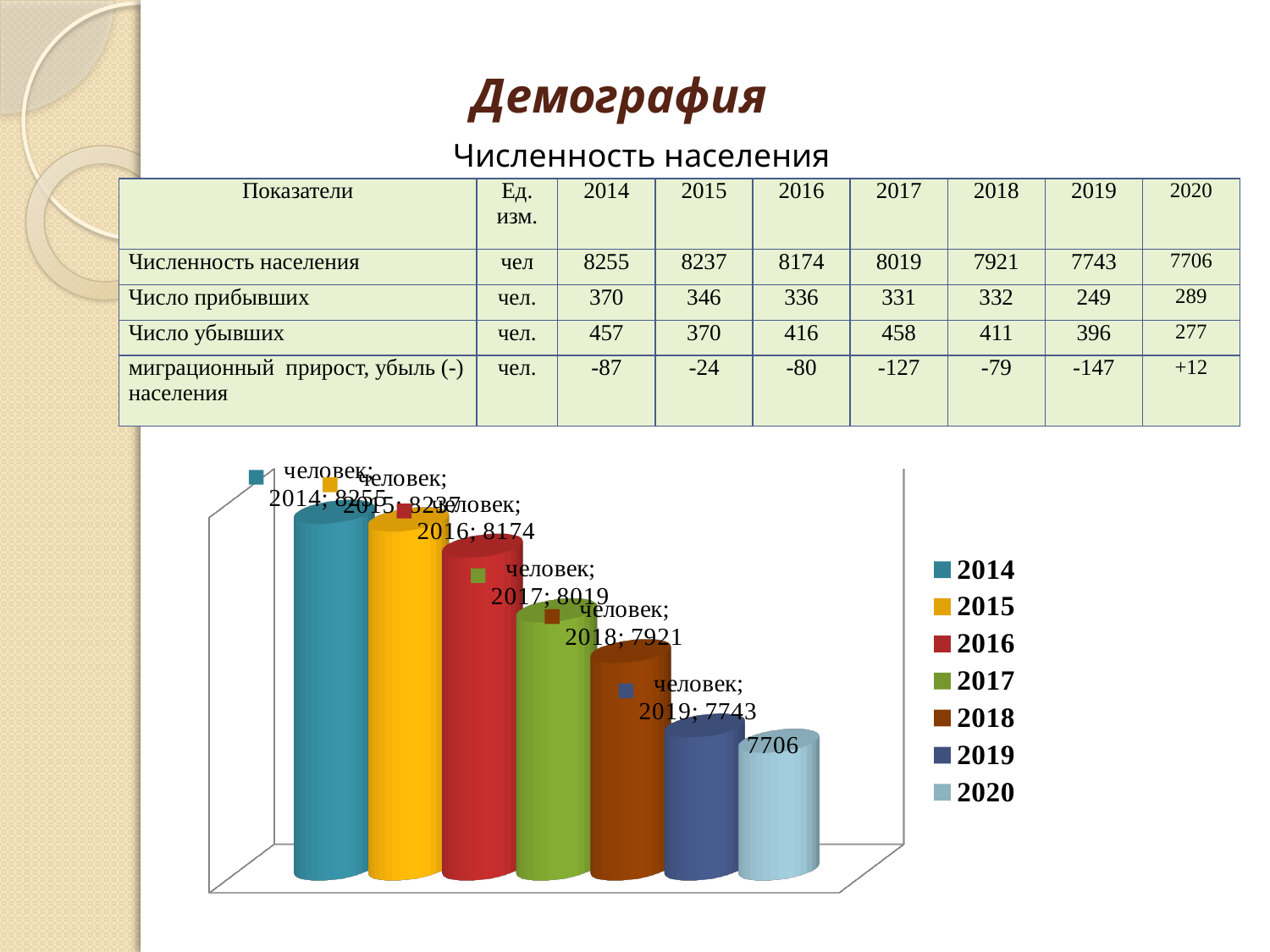
What is the difference between the population values for 2016 and 2017 in the chart? 155 What kind of chart is shown on the slide? bar chart What is the population value shown for 2020 in the chart? 7706 What is the population value shown for 2017 in the chart? 8019 What is the population value shown for 2014 in the chart? 8255 Which year has the highest population in the chart? 2014 What is the population value shown for 2018 in the chart? 7921 What is the difference between the population values for 2014 and 2020 in the chart? 549 Which is larger in the chart, the population for 2015 or for 2019? 2015 How many entries does the chart legend list? 7 How many bars are plotted in the chart? 7 Which year has the lowest population in the chart? 2020